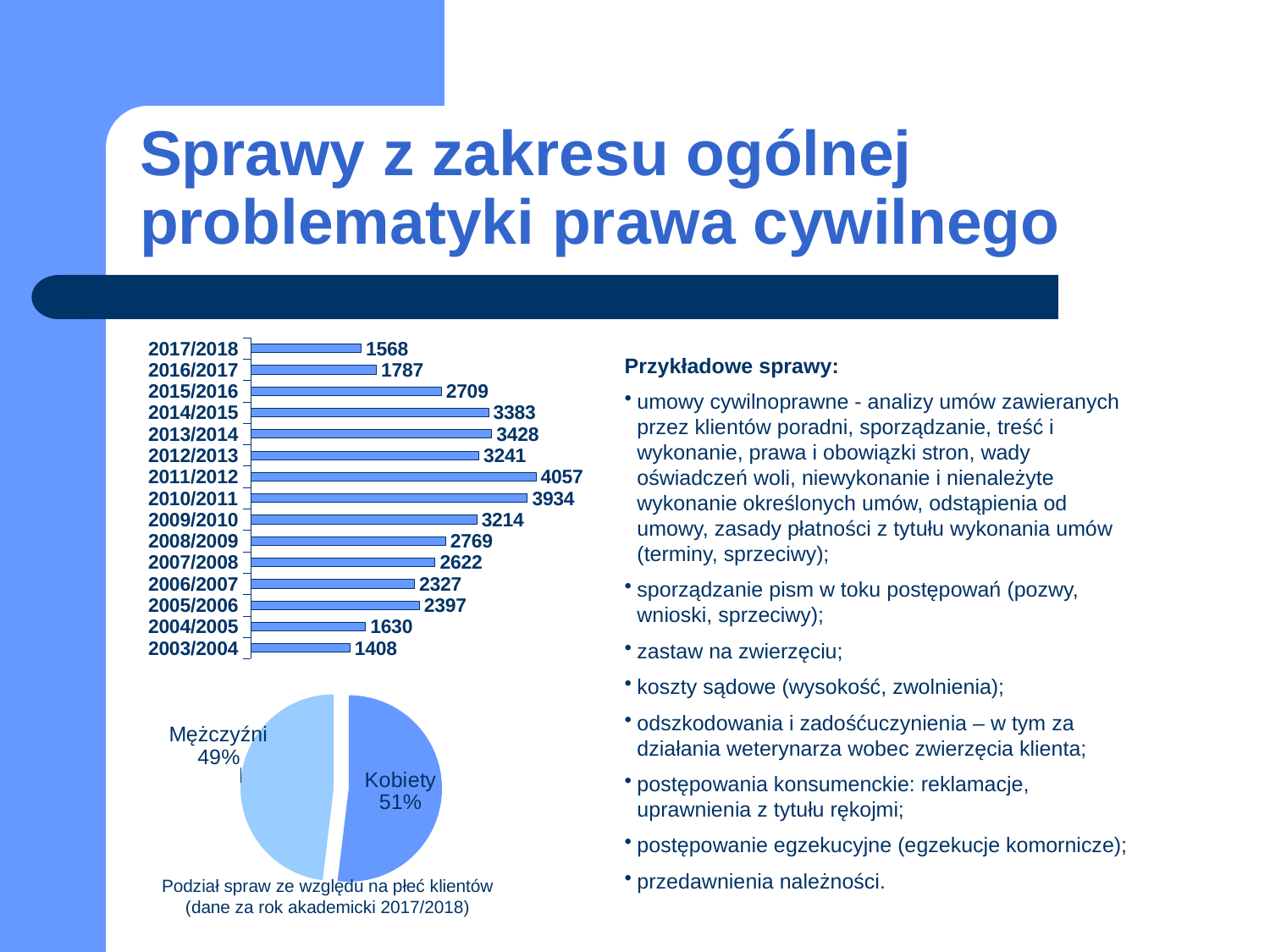
In the bar chart, which academic year has the lowest value? 2003/2004 In the bar chart, what is the value for 2017/2018? 1568 In the pie chart, which slice is larger: Kobiety or Mężczyźni? Kobiety How many academic years are shown in the bar chart? 15 In the bar chart, which is larger: the value for 2013/2014 or the value for 2014/2015? 2013/2014 In the bar chart, which academic year has the highest value? 2011/2012 In the bar chart, what is the value for 2009/2010? 3214 In the bar chart, what is the difference between the values for 2016/2017 and 2017/2018? 219 What kind of chart is the chart at the top left of the slide? bar chart In the bar chart, what is the value for 2011/2012? 4057 In the pie chart, what share of cases is for Kobiety? 51% In the bar chart, what is the difference between the values for 2011/2012 and 2010/2011? 123